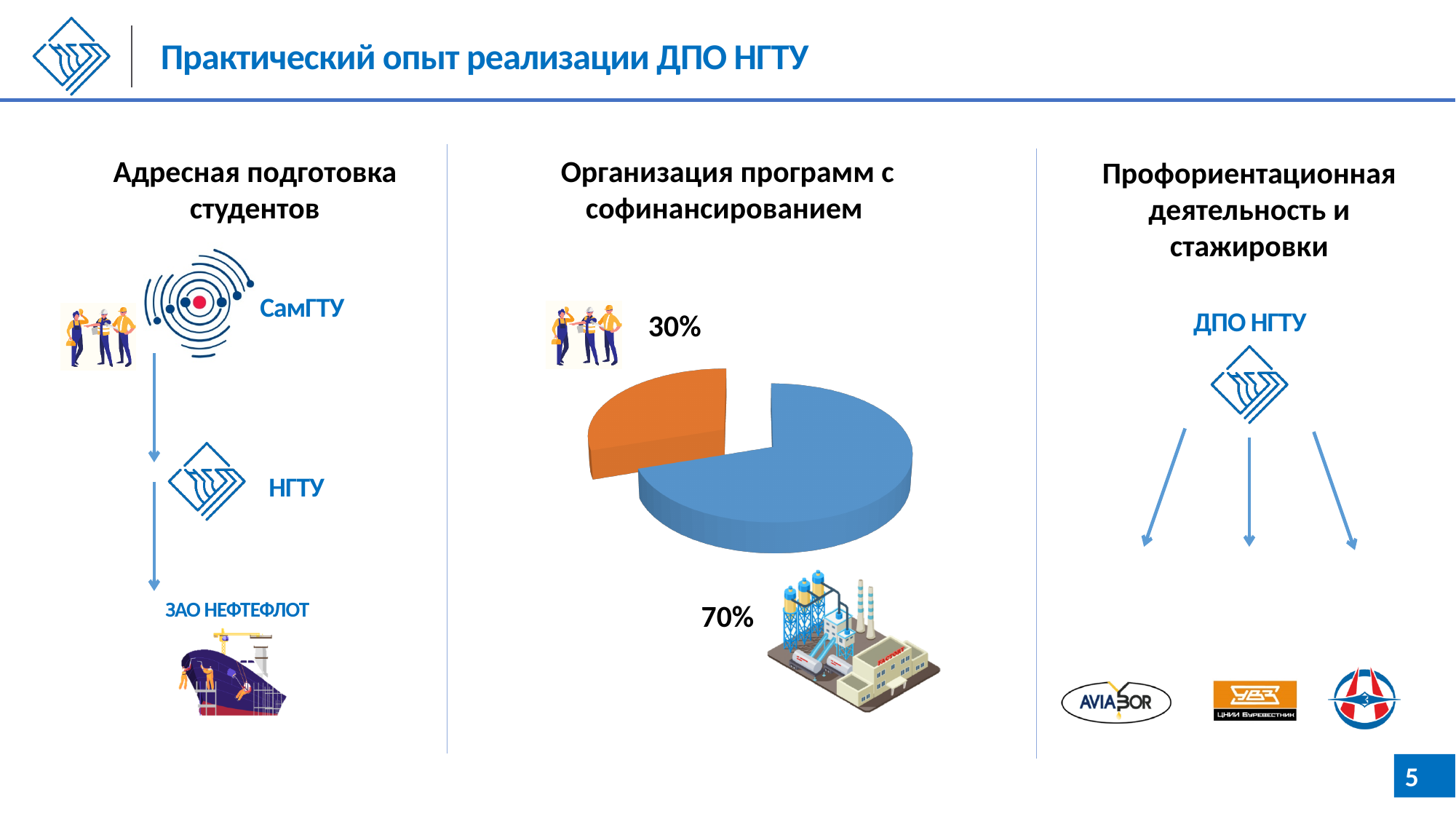
Which colour is used for the 70% slice of the pie chart? blue What share of the pie does the orange slice represent? 30% Which is larger in the pie chart, the orange slice or the blue slice? the blue slice What do the two slices of the pie chart add up to? 100% What percentage is shown for the blue slice of the pie chart? 70% Which slice of the pie chart is the largest? the blue slice (70%) Which slice of the pie chart is the smallest? the orange slice (30%) What kind of chart is shown in the middle section of the slide, under "Организация программ с софинансированием"? pie chart Under which heading does the pie chart appear on the slide? Организация программ с софинансированием What percentage is shown for the orange slice of the pie chart? 30% What is the difference in percentage points between the blue slice and the orange slice of the pie chart? 40 How many slices does the pie chart have? 2